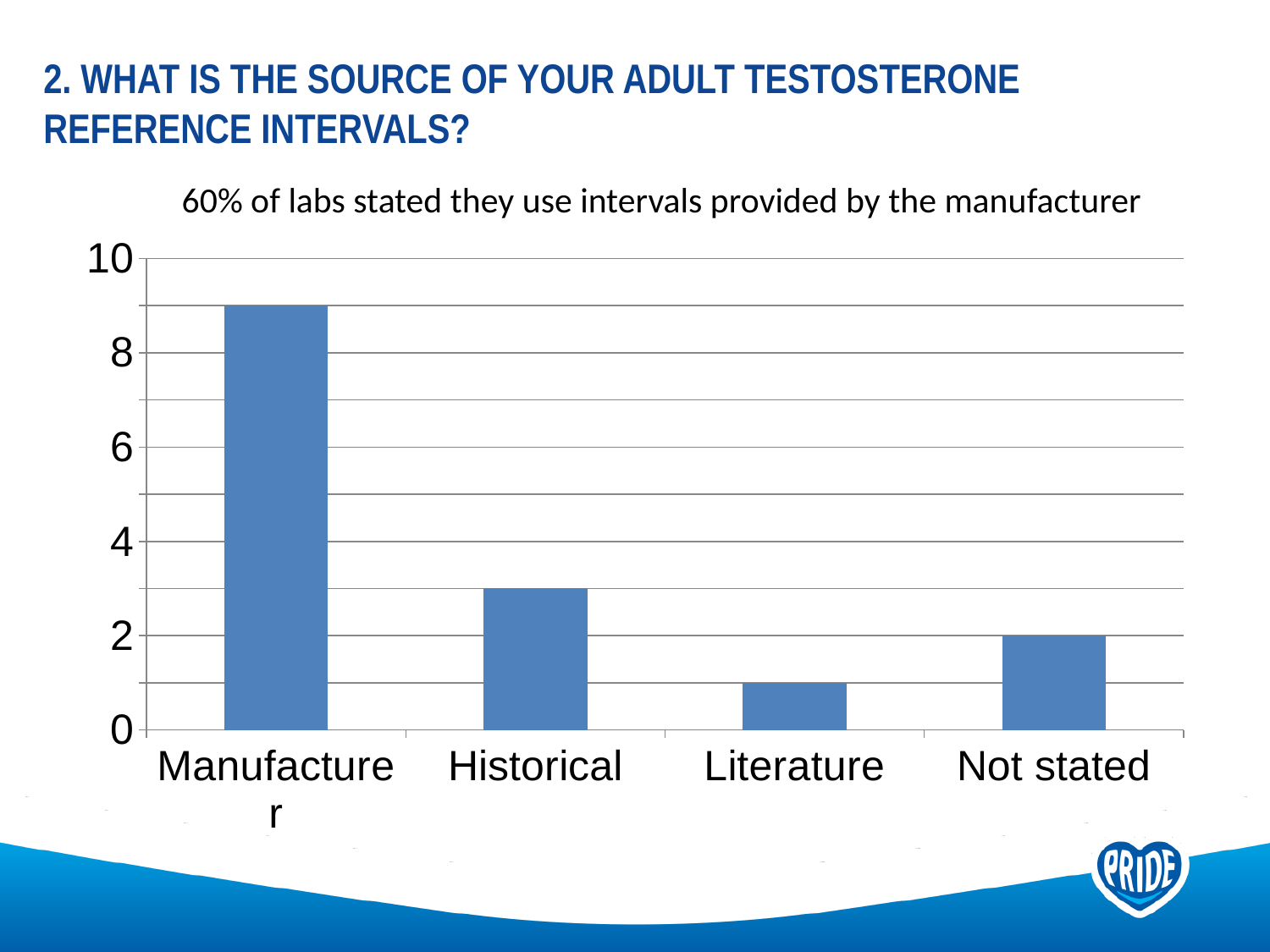
What is the highest value labelled on the y axis? 10 What kind of chart is shown on the slide? bar chart How many categories are shown on the x axis of the chart? 4 Which is larger, the value for Historical or the value for Not stated? Historical Which category has the lowest bar? Literature Is the value for Historical greater or less than 4? less Is the value for Literature greater or less than 2? less Is the value for Manufacturer greater or less than 8? greater Which is larger, the value for Manufacturer or the value for Historical? Manufacturer According to the text above the chart, what percentage of labs stated they use intervals provided by the manufacturer? 60% What is the value for Not stated? 2 Which category has the highest bar? Manufacturer